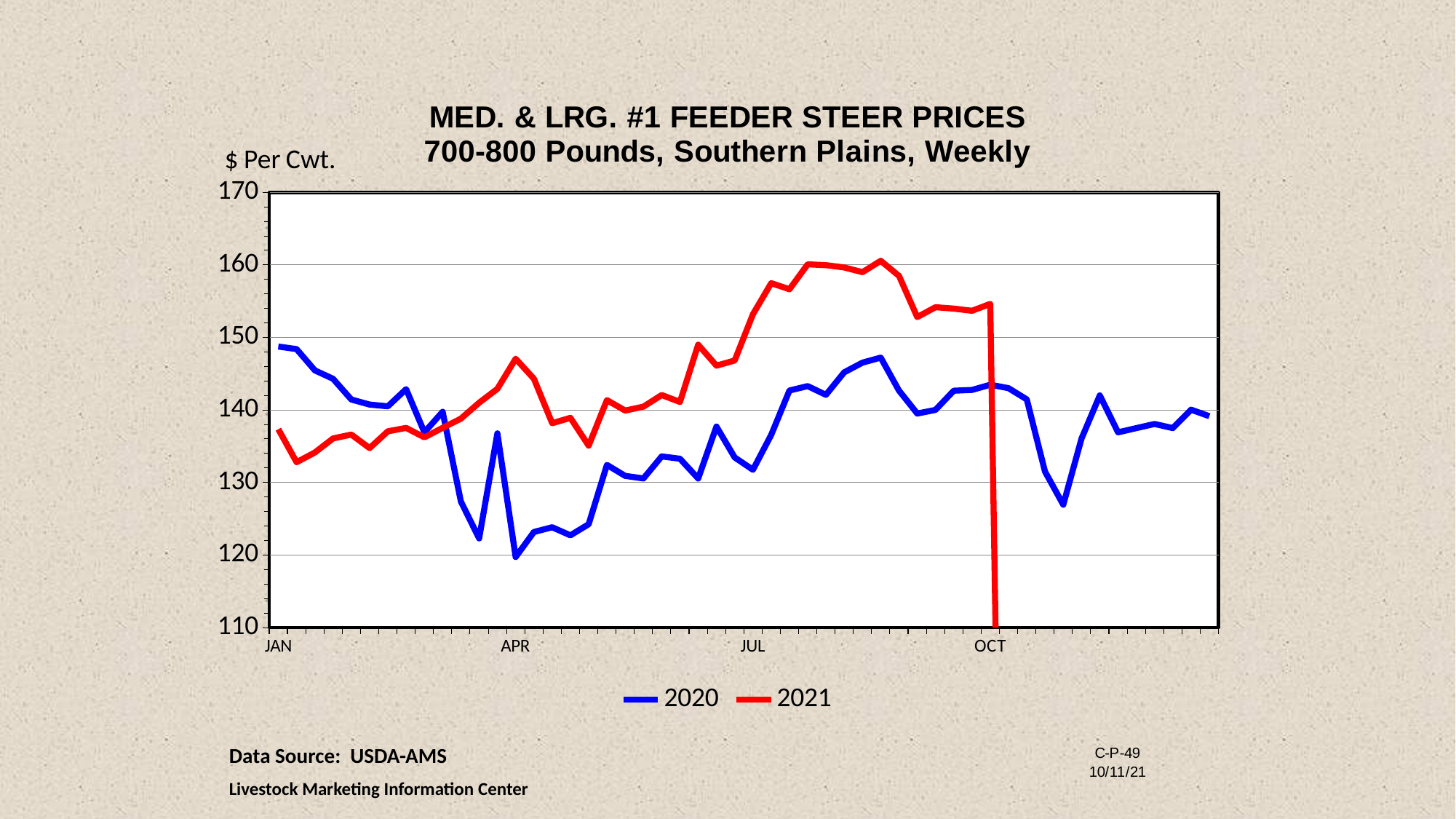
How many series does the legend list? 2 At JAN, which series has the higher value, 2020 or 2021? 2020 Is the 2021 value at JAN greater or less than 140? less Is the lowest value reached by the 2020 line greater or less than 130? less What kind of chart is shown on the slide? line chart Is the highest value reached by the 2021 line greater or less than 150? greater What colour is the line for the 2021 series? red Does the 2021 line generally rise or fall from JAN to OCT? rise What are the two series named in the legend? 2020 and 2021 Which series reaches the highest value on the chart? 2021 At JUL, which series has the higher value, 2020 or 2021? 2021